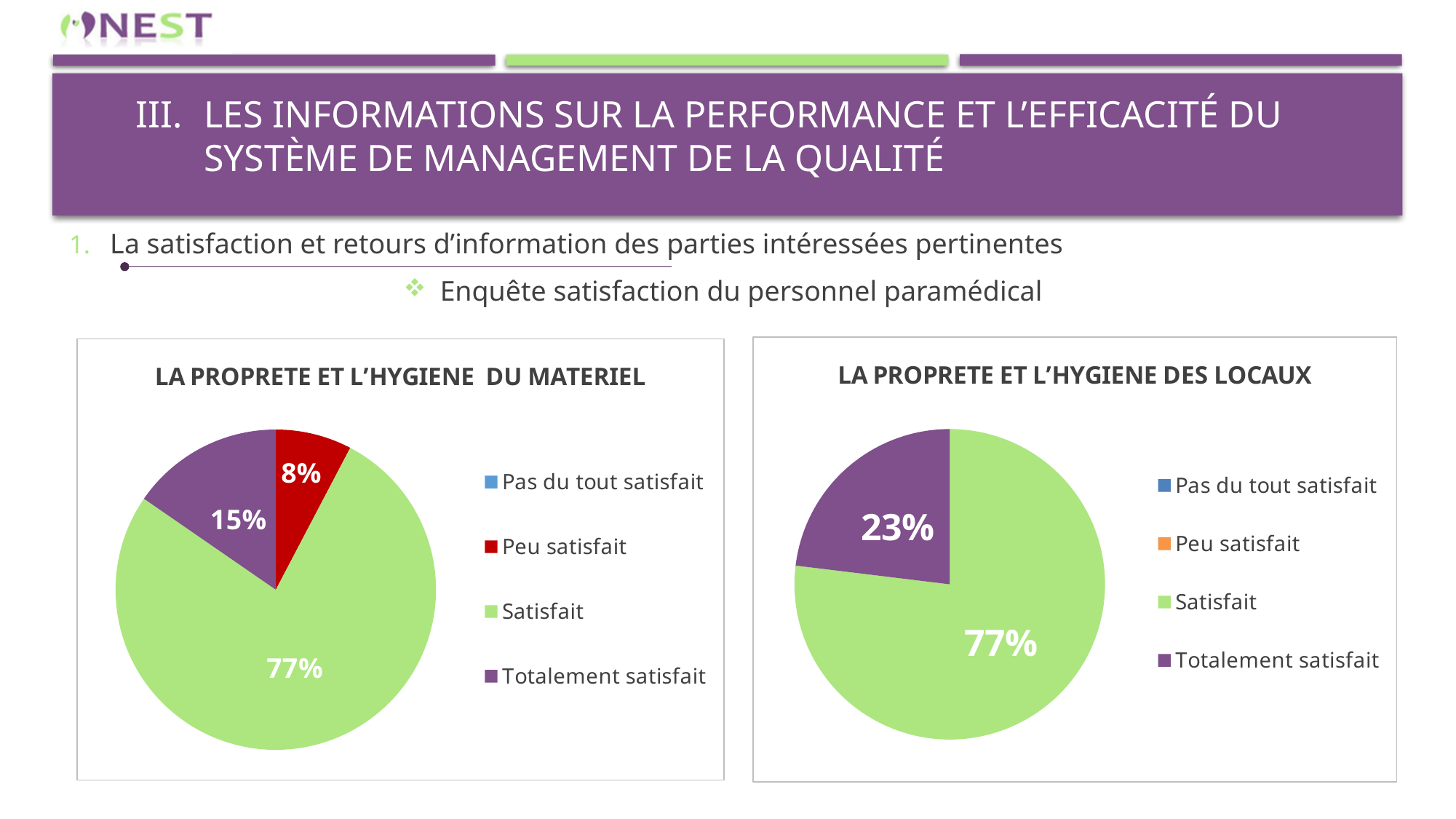
In the chart titled "LA PROPRETE ET L'HYGIENE DU MATERIEL", which labelled slice is the smallest? Peu satisfait In the chart titled "LA PROPRETE ET L'HYGIENE DU MATERIEL", what is the difference between the "Totalement satisfait" and "Peu satisfait" shares? 7% How many entries does the legend of the chart titled "LA PROPRETE ET L'HYGIENE DES LOCAUX" list? 4 In the chart titled "LA PROPRETE ET L'HYGIENE DU MATERIEL", what share of respondents answered "Peu satisfait"? 8% In the chart titled "LA PROPRETE ET L'HYGIENE DES LOCAUX", what share of respondents answered "Totalement satisfait"? 23% In the chart titled "LA PROPRETE ET L'HYGIENE DU MATERIEL", what share of respondents answered "Satisfait"? 77% In the chart titled "LA PROPRETE ET L'HYGIENE DES LOCAUX", what is the difference between the "Satisfait" and "Totalement satisfait" shares? 54% In the chart titled "LA PROPRETE ET L'HYGIENE DU MATERIEL", what share of respondents answered "Totalement satisfait"? 15% In the chart titled "LA PROPRETE ET L'HYGIENE DU MATERIEL", which category has the largest slice? Satisfait In the chart titled "LA PROPRETE ET L'HYGIENE DES LOCAUX", what share of respondents answered "Satisfait"? 77% Which is larger: the "Totalement satisfait" share in the chart on the left or the "Totalement satisfait" share in the chart on the right? The chart on the right What type of chart is used in the chart titled "LA PROPRETE ET L'HYGIENE DES LOCAUX"? Pie chart